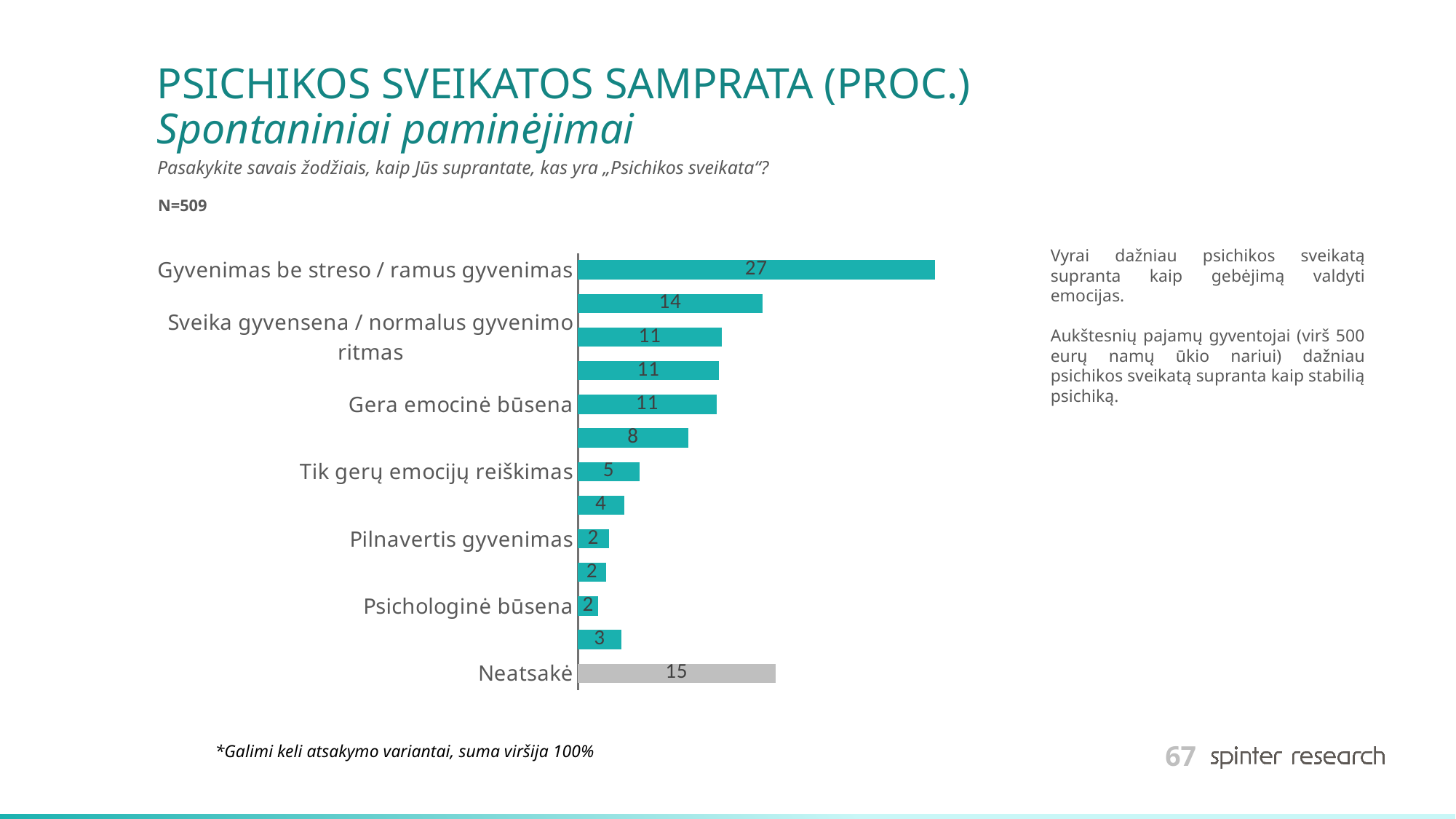
What is the value for "Gera emocinė būsena"? 11 What type of chart is shown on the slide? Bar chart What is the difference between the values for "Gyvenimas be streso / ramus gyvenimas" and "Neatsakė"? 12 What is the value for "Pilnavertis gyvenimas"? 2 What is the value for "Gyvenimas be streso / ramus gyvenimas"? 27 Which is larger, the value for "Neatsakė" or the value for "Gera emocinė būsena"? Neatsakė Which category has the highest value in the chart? Gyvenimas be streso / ramus gyvenimas What is the difference between the values for "Gera emocinė būsena" and "Tik gerų emocijų reiškimas"? 6 How many bars are plotted in the chart? 13 What is the value for "Tik gerų emocijų reiškimas"? 5 What colour is the bar for "Neatsakė"? Grey What is the value for "Neatsakė"? 15